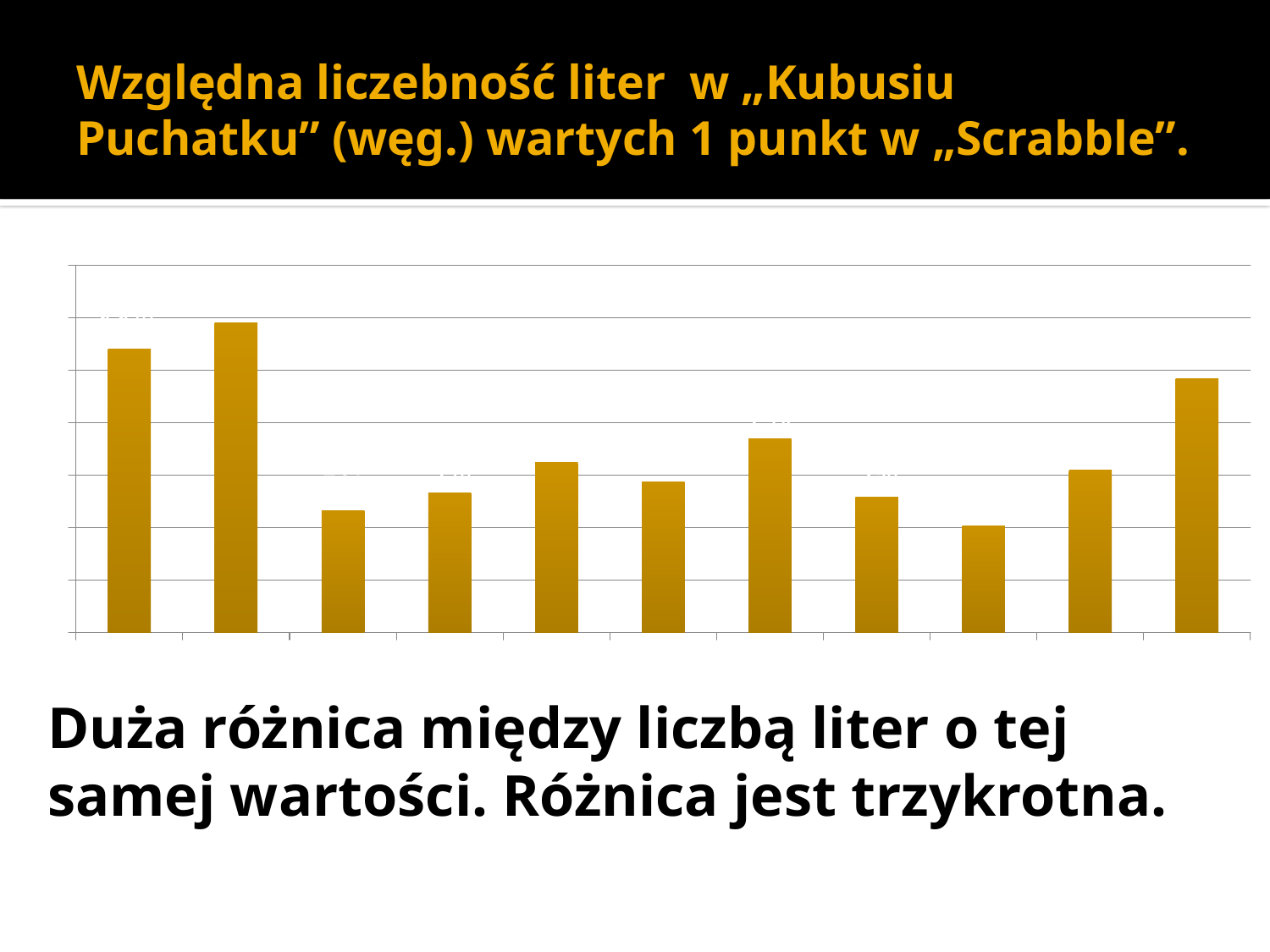
Which is taller, the first bar or the last bar? the first bar Which is taller, the tenth bar or the eleventh bar from the left? the eleventh bar Which is taller, the third bar or the ninth bar from the left? the third bar Which bar, counted from the left, is the tallest in the chart? the second bar According to the slide title, letters worth how many points in Scrabble does the chart cover? 1 punkt What kind of chart is shown on the slide? bar chart Which bar, counted from the left, is the shortest in the chart? the ninth bar How many bars does the chart contain? 11 What colour are the bars in the chart? gold (yellow-orange)